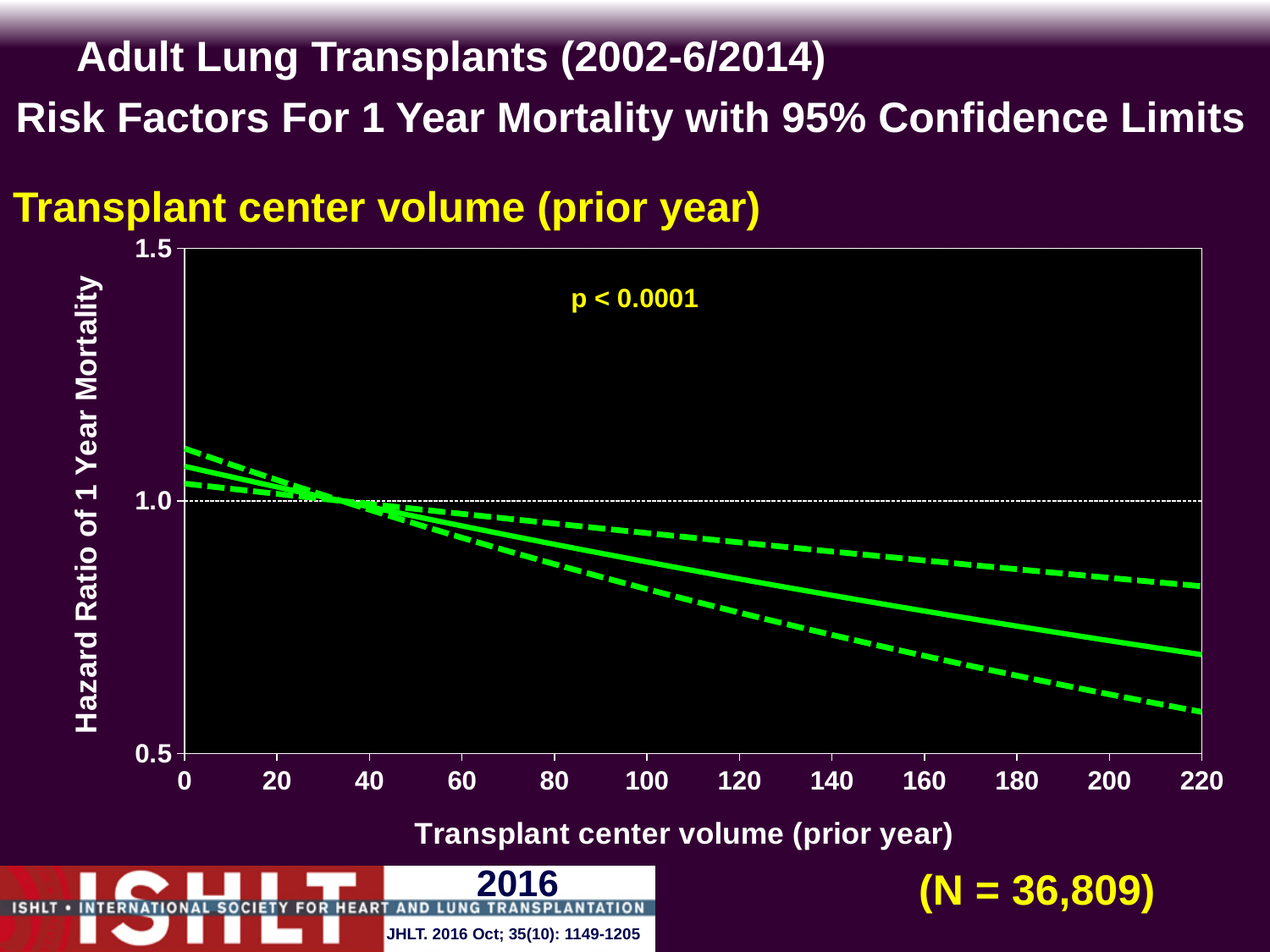
Is the lower confidence limit (lower dashed line) at a transplant center volume of 220 greater or less than 0.5? greater Is the hazard ratio (solid line) at a transplant center volume of 100 greater or less than 1.0? less Is the hazard ratio (solid line) at a transplant center volume of 0 greater or less than 1.0? greater How many lines are plotted on the chart? 3 What p-value is printed on the chart? p < 0.0001 What is the highest value labelled on the x axis? 220 What kind of chart is shown on the slide? line chart Does the hazard ratio of 1 year mortality rise or fall as transplant center volume increases? fall How many tick labels are shown on the x axis? 12